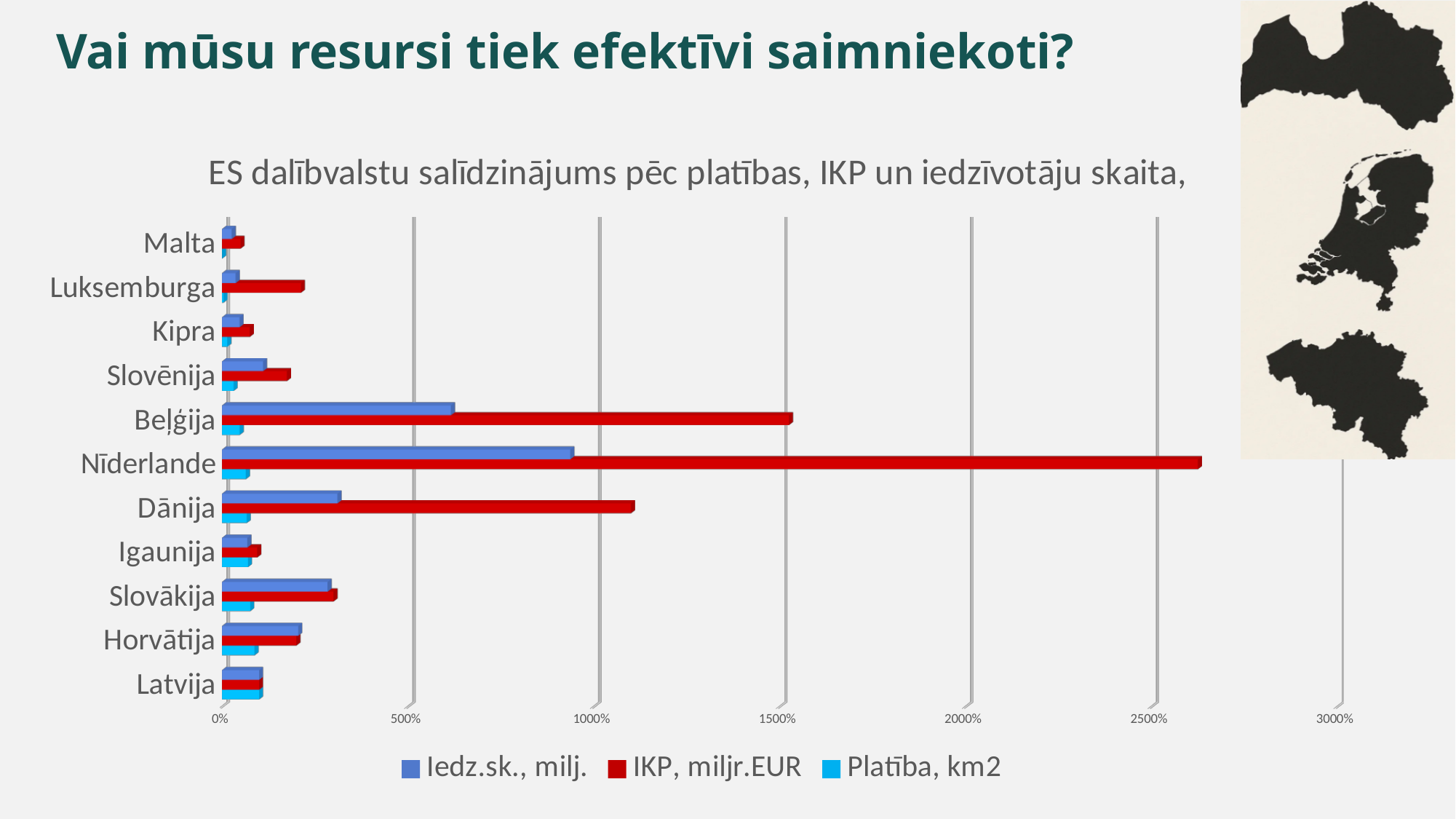
How many countries are listed on the chart's vertical axis? 11 Is the Iedz.sk., milj. value for Beļģija greater or less than 500%? greater Which country has the highest value for the IKP, miljr.EUR series? Nīderlande Which has the larger IKP, miljr.EUR value, Beļģija or Dānija? Beļģija Which country has the highest value for the Iedz.sk., milj. series? Nīderlande What kind of chart is shown on the slide? bar chart Is the Iedz.sk., milj. value for Nīderlande greater or less than 1000%? less Which series is shown in red in the chart's legend? IKP, miljr.EUR Is the IKP, miljr.EUR value for Nīderlande greater or less than 2500%? greater How many series does the chart's legend list? 3 What is the title of the chart? ES dalībvalstu salīdzinājums pēc platības, IKP un iedzīvotāju skaita,